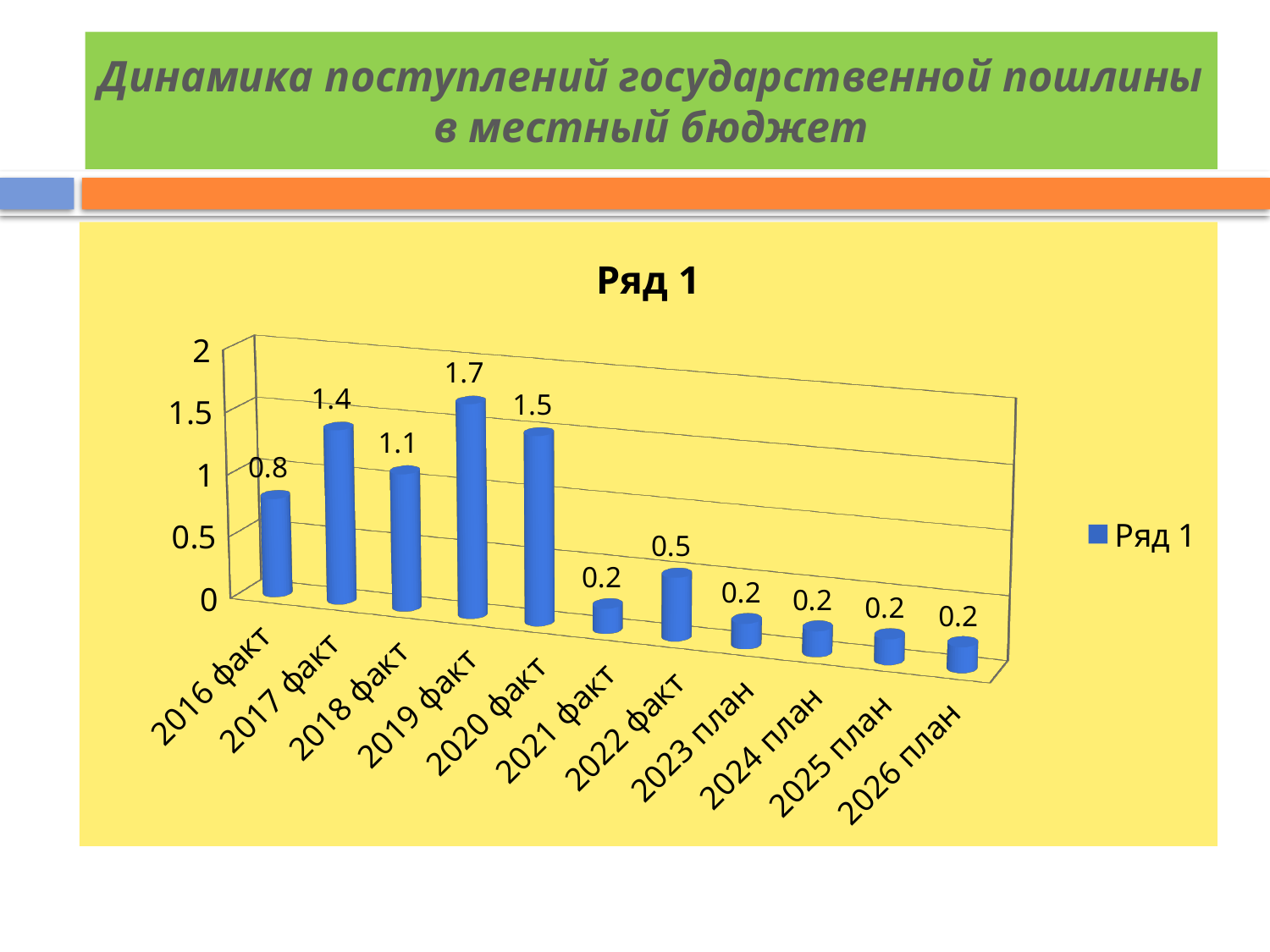
How many series does the legend list? 1 What kind of chart is shown on the slide? bar chart Which is larger, the value for 2017 факт or the value for 2018 факт? 2017 факт Which category has the highest value? 2019 факт Is the value for 2020 факт greater or less than 1? greater What is the difference between the values for 2019 факт and 2020 факт? 0.2 What is the title of the chart? Ряд 1 What is the value for 2019 факт? 1.7 What is the difference between the values for 2017 факт and 2018 факт? 0.3 How many categories are shown on the x axis? 11 What is the value for 2016 факт? 0.8 What is the value for 2022 факт? 0.5